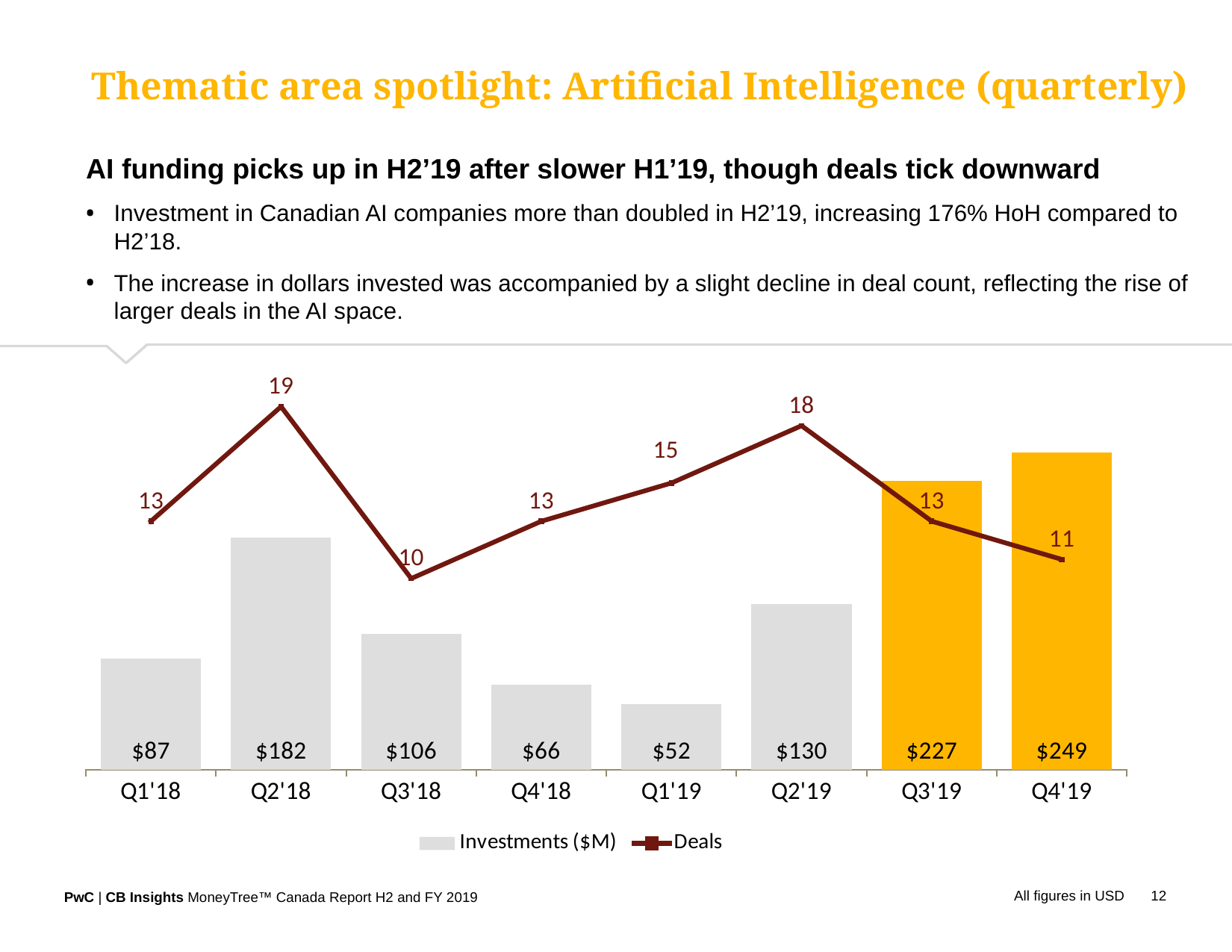
Which quarter has the highest Investments ($M)? Q4'19 How many series does the legend list? 2 What is the value of Investments ($M) for Q3'19? $227 What is the difference in Investments ($M) between Q4'19 and Q3'19? $22 Which quarter has the lowest number of Deals? Q3'18 How many quarters are shown on the x axis? 8 How many Deals were there in Q2'18? 19 Which quarter has the lowest Investments ($M)? Q1'19 Which is larger, Investments ($M) in Q2'18 or in Q2'19? Q2'18 What kind of chart is used to show Investments ($M)? Bar chart What is the difference in Deals between Q2'18 and Q3'18? 9 Do Deals rise or fall from Q2'19 to Q4'19? Fall